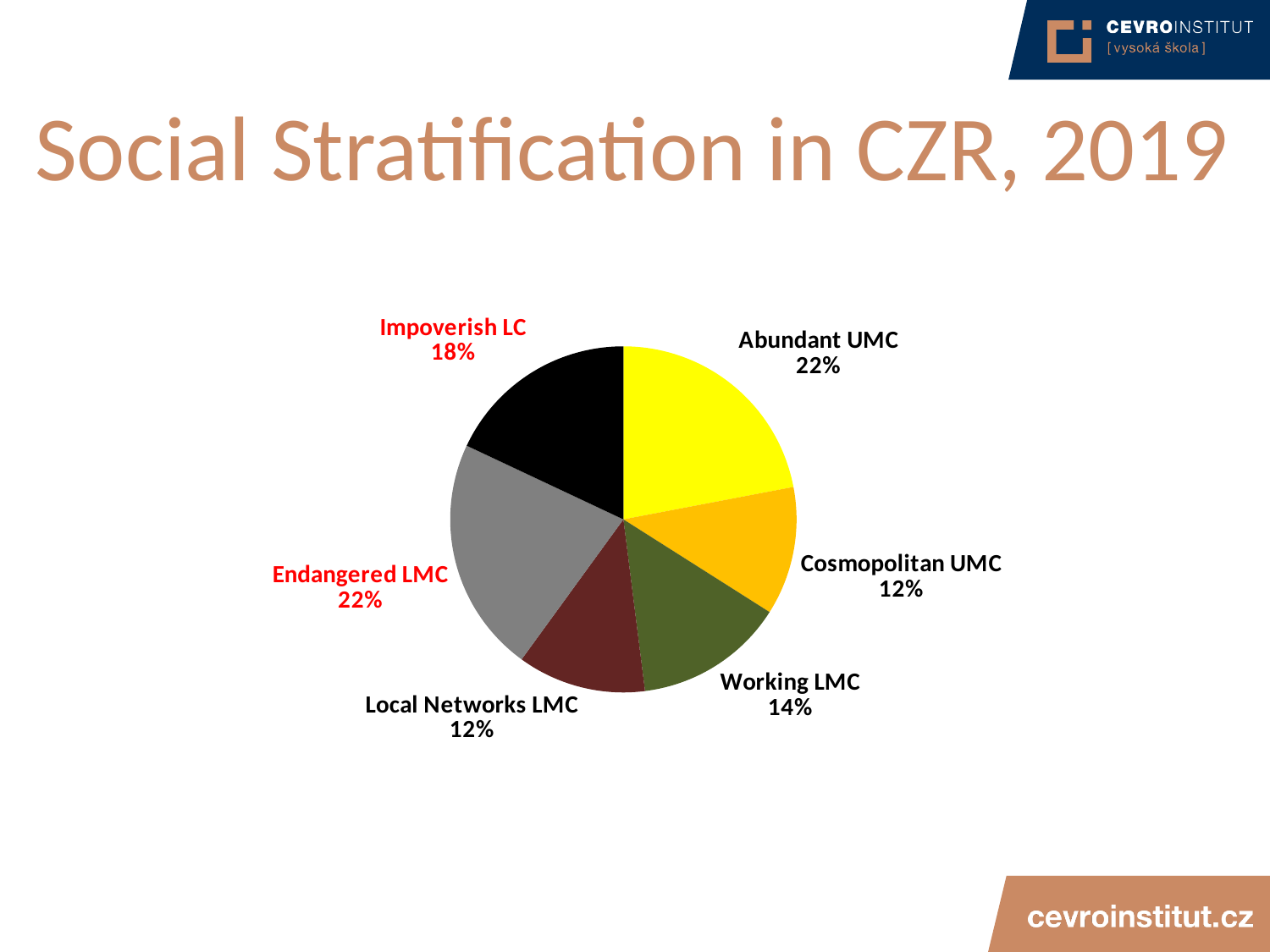
Which is larger, Abundant UMC or Cosmopolitan UMC? Abundant UMC What share is shown for Endangered LMC? 22% What colour is the Abundant UMC slice? Yellow What kind of chart is shown on the slide? Pie chart What is the difference in percentage points between Abundant UMC and Working LMC? 8 percentage points Which is larger, the share for Impoverish LC or the share for Working LMC? Impoverish LC What share of the pie does Abundant UMC hold? 22% What percentage is labelled for Working LMC? 14% What is the value for Impoverish LC? 18% What is the value for Local Networks LMC? 12% How many slices does the pie chart have? 6 What is the value shown for Cosmopolitan UMC? 12%